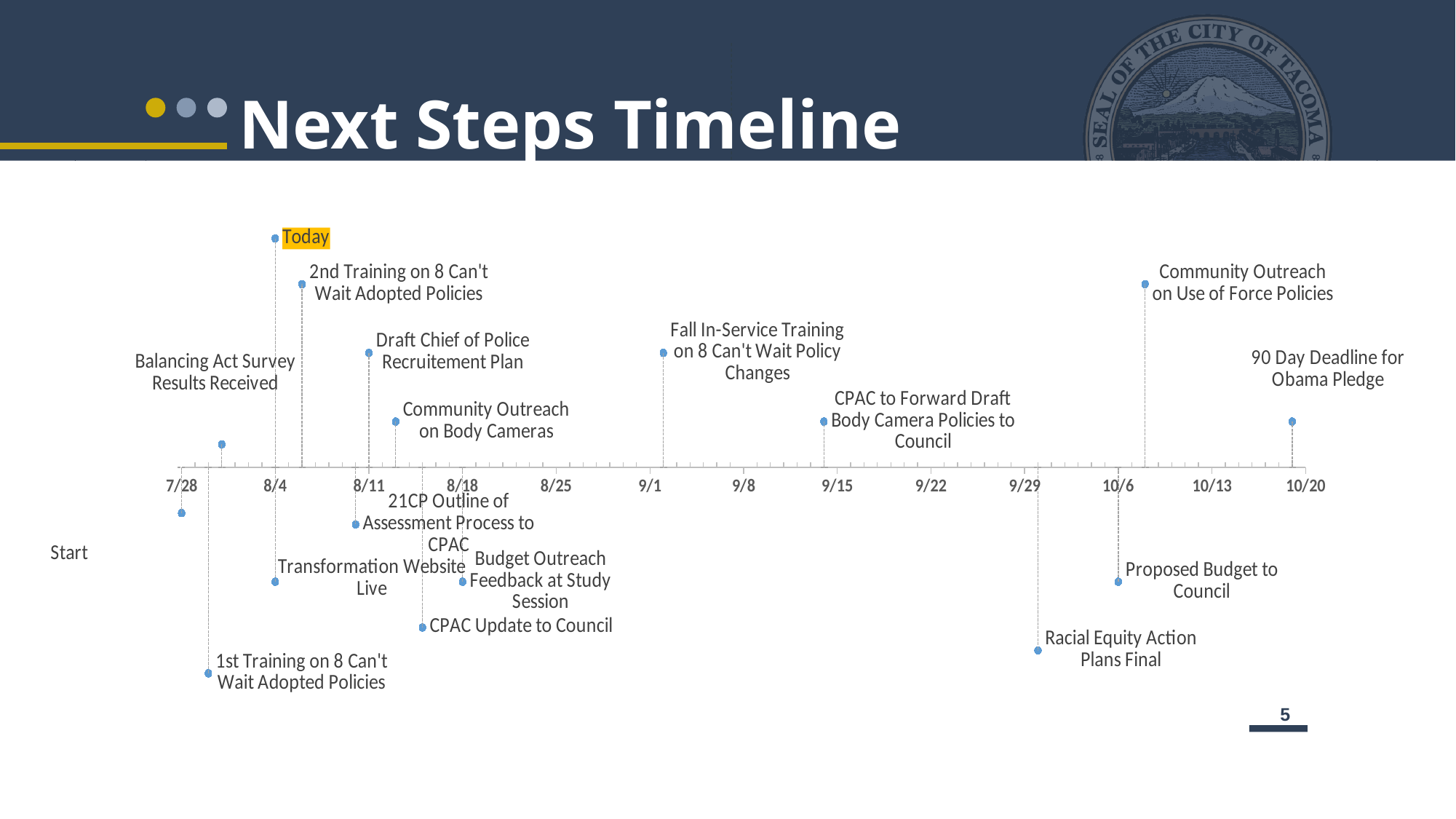
Which event label on the timeline is highlighted in yellow? Today Which event is the latest on the timeline? 90 Day Deadline for Obama Pledge What kind of chart is shown on the slide? Timeline chart On which date does 'Proposed Budget to Council' fall on the timeline? 10/6 Which comes earlier on the timeline, 'Draft Chief of Police Recruitement Plan' or 'Fall In-Service Training on 8 Can't Wait Policy Changes'? Draft Chief of Police Recruitement Plan Which event is the earliest on the timeline? Start Which comes later on the timeline, 'Racial Equity Action Plans Final' or 'Proposed Budget to Council'? Proposed Budget to Council What is the title of the chart on the slide? Next Steps Timeline Is 'CPAC to Forward Draft Body Camera Policies to Council' before or after 9/8 on the timeline? after On which date does the 'Today' marker fall on the timeline? 8/4 On which date does the 'Start' marker fall on the timeline? 7/28 How many date labels are shown along the timeline axis? 13